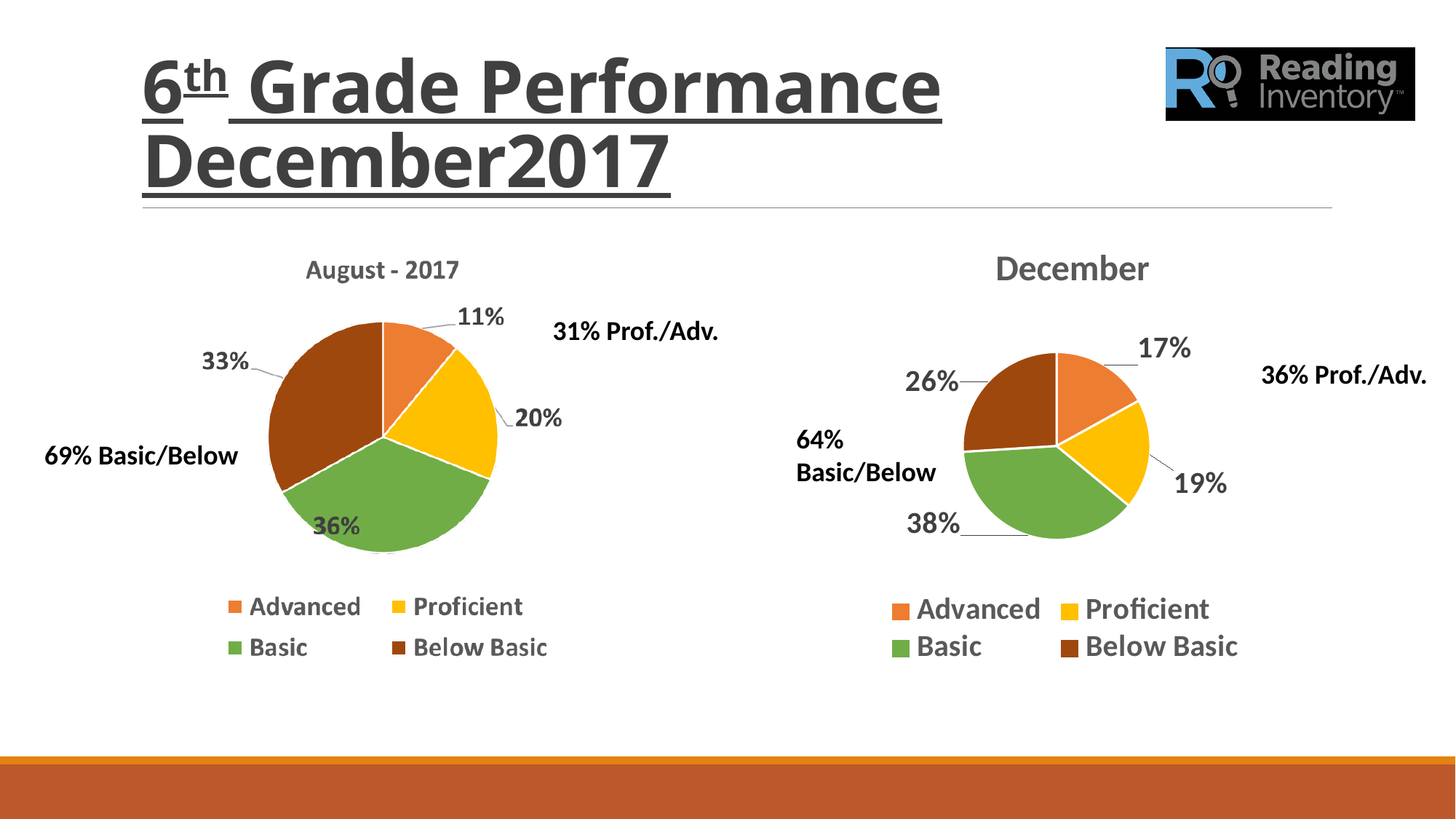
In the 'August - 2017' pie chart, which category has the smallest slice? Advanced What type of chart is the 'August - 2017' chart? Pie chart In the 'August - 2017' pie chart, what percentage is shown for Basic? 36% In the 'August - 2017' pie chart, which colour represents Below Basic? Brown In the 'August - 2017' pie chart, what percentage is shown for Below Basic? 33% How many slices does the 'December' pie chart have? 4 Which is larger: the Advanced slice in the 'August - 2017' chart or the Advanced slice in the 'December' chart? December What is the difference between the Below Basic percentage in the 'August - 2017' chart and the Below Basic percentage in the 'December' chart? 7% In the 'December' pie chart, what percentage is shown for Proficient? 19% In the 'December' pie chart, which category has the largest slice? Basic In the 'December' pie chart, what percentage is shown for Advanced? 17% In the 'December' pie chart, what is the combined share of Advanced and Proficient? 36%